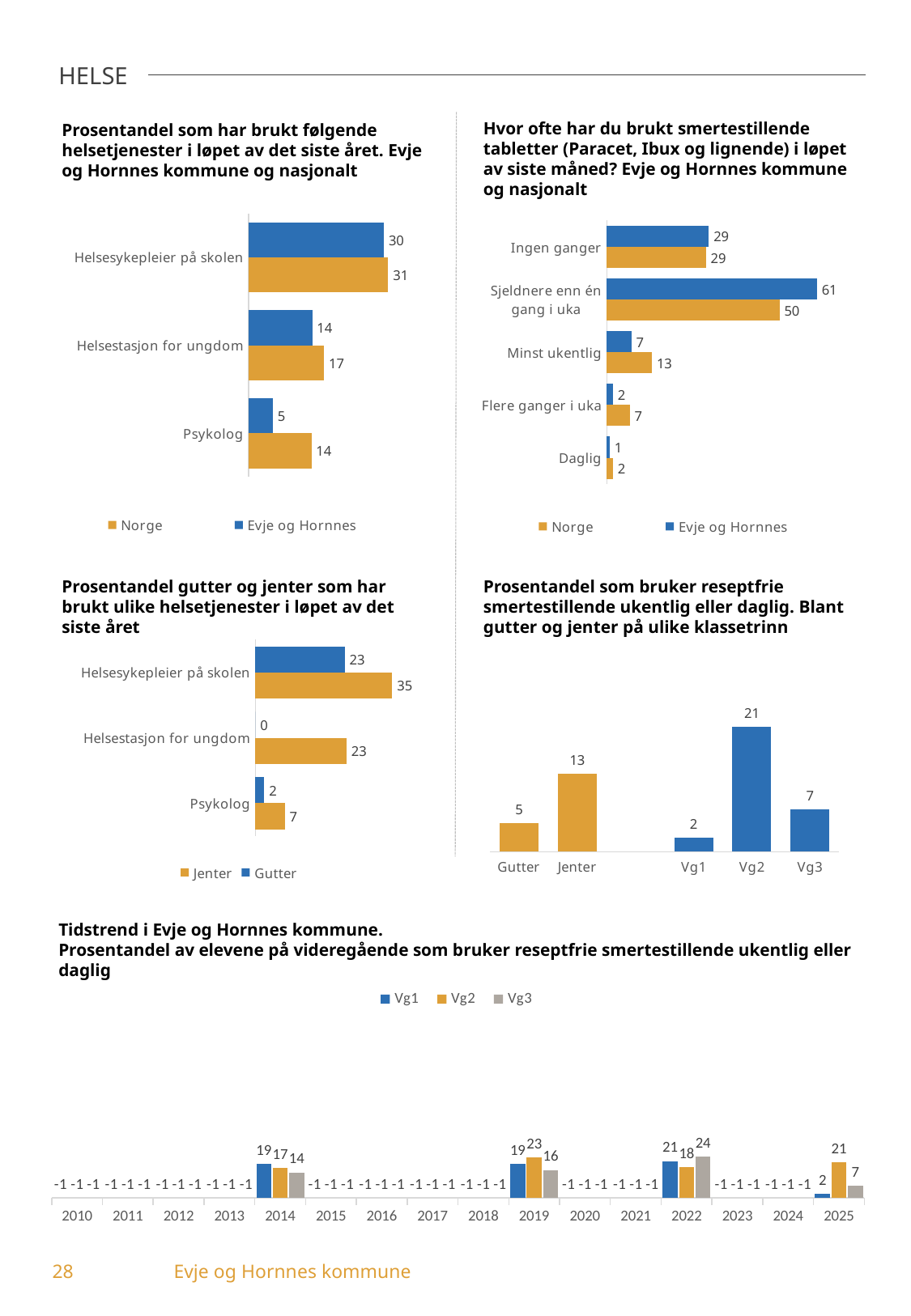
In the chart 'Hvor ofte har du brukt smertestillende tabletter', how many categories are shown? 5 In the bottom chart 'Tidstrend i Evje og Hornnes kommune', what is the Vg3 value for 2022? 24 In the chart 'Prosentandel som har brukt følgende helsetjenester i løpet av det siste året', what is the value for Psykolog for Evje og Hornnes? 5 In the chart 'Prosentandel som bruker reseptfrie smertestillende ukentlig eller daglig', what is the value for Vg2? 21 In the chart 'Prosentandel gutter og jenter som har brukt ulike helsetjenester', which is larger for Helsesykepleier på skolen, Jenter or Gutter? Jenter In the bottom chart 'Tidstrend i Evje og Hornnes kommune', how many series does the legend list? 3 In the chart 'Hvor ofte har du brukt smertestillende tabletter', what is the Norge value for Minst ukentlig? 13 In the chart 'Hvor ofte har du brukt smertestillende tabletter', which category has the highest value for Evje og Hornnes? Sjeldnere enn én gang i uka What kind of chart is the bottom chart 'Tidstrend i Evje og Hornnes kommune'? Bar chart In the chart 'Prosentandel som har brukt følgende helsetjenester i løpet av det siste året', what is the difference between the Norge and Evje og Hornnes values for Helsestasjon for ungdom? 3 In the chart 'Prosentandel som bruker reseptfrie smertestillende ukentlig eller daglig', which category has the lowest value? Vg1 In the chart 'Prosentandel gutter og jenter som har brukt ulike helsetjenester', what is the value for Gutter for Helsestasjon for ungdom? 0